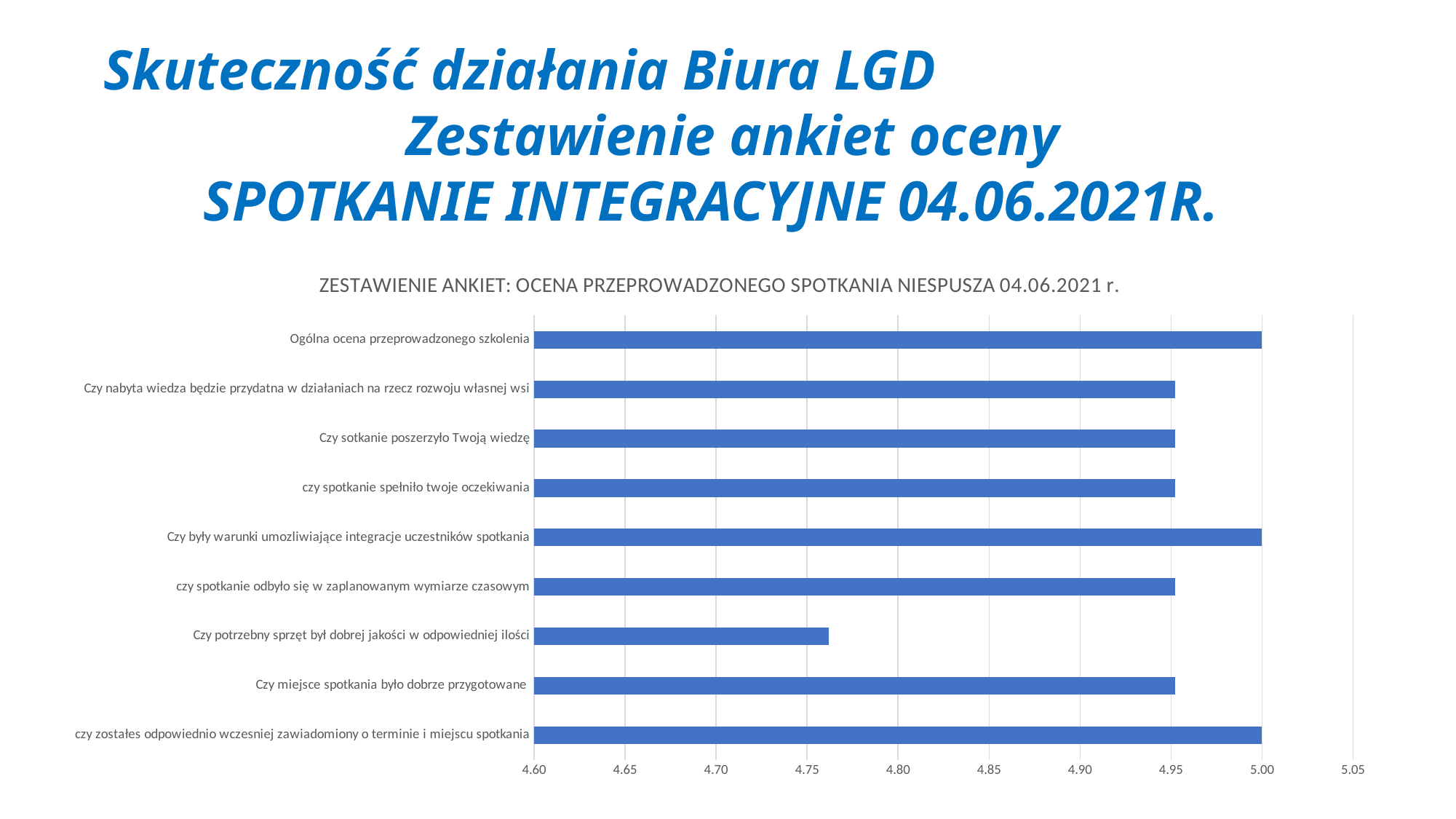
Which is larger: the value for "Ogólna ocena przeprowadzonego szkolenia" or the value for "Czy potrzebny sprzęt był dobrej jakości w odpowiedniej ilości"? Ogólna ocena przeprowadzonego szkolenia What is the value for "Czy były warunki umozliwiające integracje uczestników spotkania"? 5.00 Is the value for "Czy potrzebny sprzęt był dobrej jakości w odpowiedniej ilości" greater or less than 4.80? less What colour are the bars in the chart? blue Which category has the lowest value? Czy potrzebny sprzęt był dobrej jakości w odpowiedniej ilości Is the value for "Czy potrzebny sprzęt był dobrej jakości w odpowiedniej ilości" greater or less than 4.75? greater What is the title of the chart? ZESTAWIENIE ANKIET: OCENA PRZEPROWADZONEGO SPOTKANIA NIESPUSZA 04.06.2021 r. What type of chart is shown on the slide? bar chart What is the value for "Ogólna ocena przeprowadzonego szkolenia"? 5.00 How many categories (questions) are plotted in the chart? 9 What is the value for "czy zostałes odpowiednio wczesniej zawiadomiony o terminie i miejscu spotkania"? 5.00 Is the value for "Czy miejsce spotkania było dobrze przygotowane" greater or less than 4.90? greater